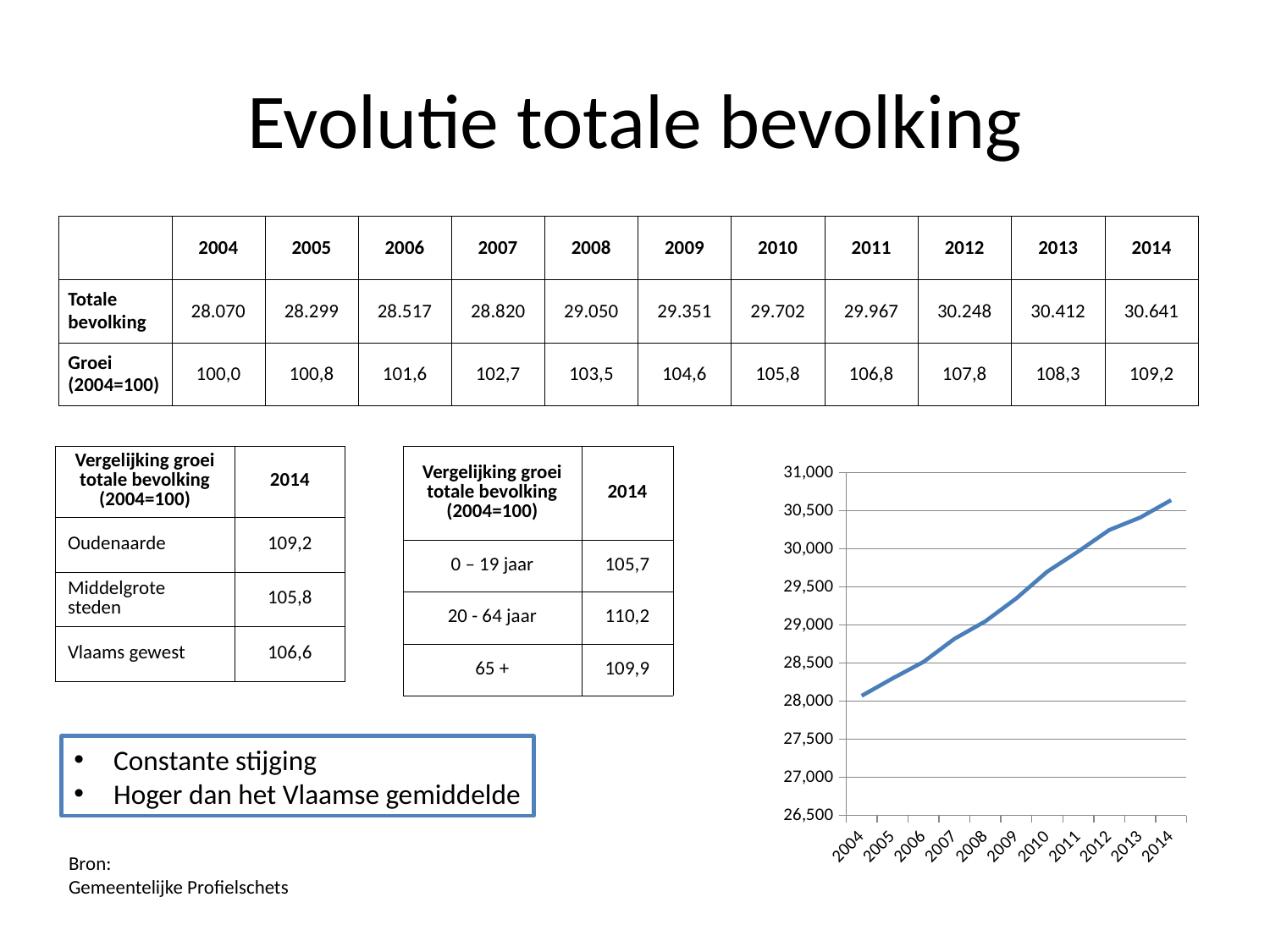
Which is larger in the chart, the value for 2007 or the value for 2011? 2011 How many years are plotted along the x axis of the chart? 11 Is the value for 2012 in the chart greater or less than 30,000? greater Is the value for 2010 in the chart greater or less than 29,500? greater What kind of chart is shown on the slide? line chart Which year has the lowest value in the chart? 2004 Is the value for 2009 in the chart greater or less than 29,500? less Do the values in the chart rise or fall from 2004 to 2014? rise Which year has the highest value in the chart? 2014 What is the lowest tick value shown on the y axis of the chart? 26,500